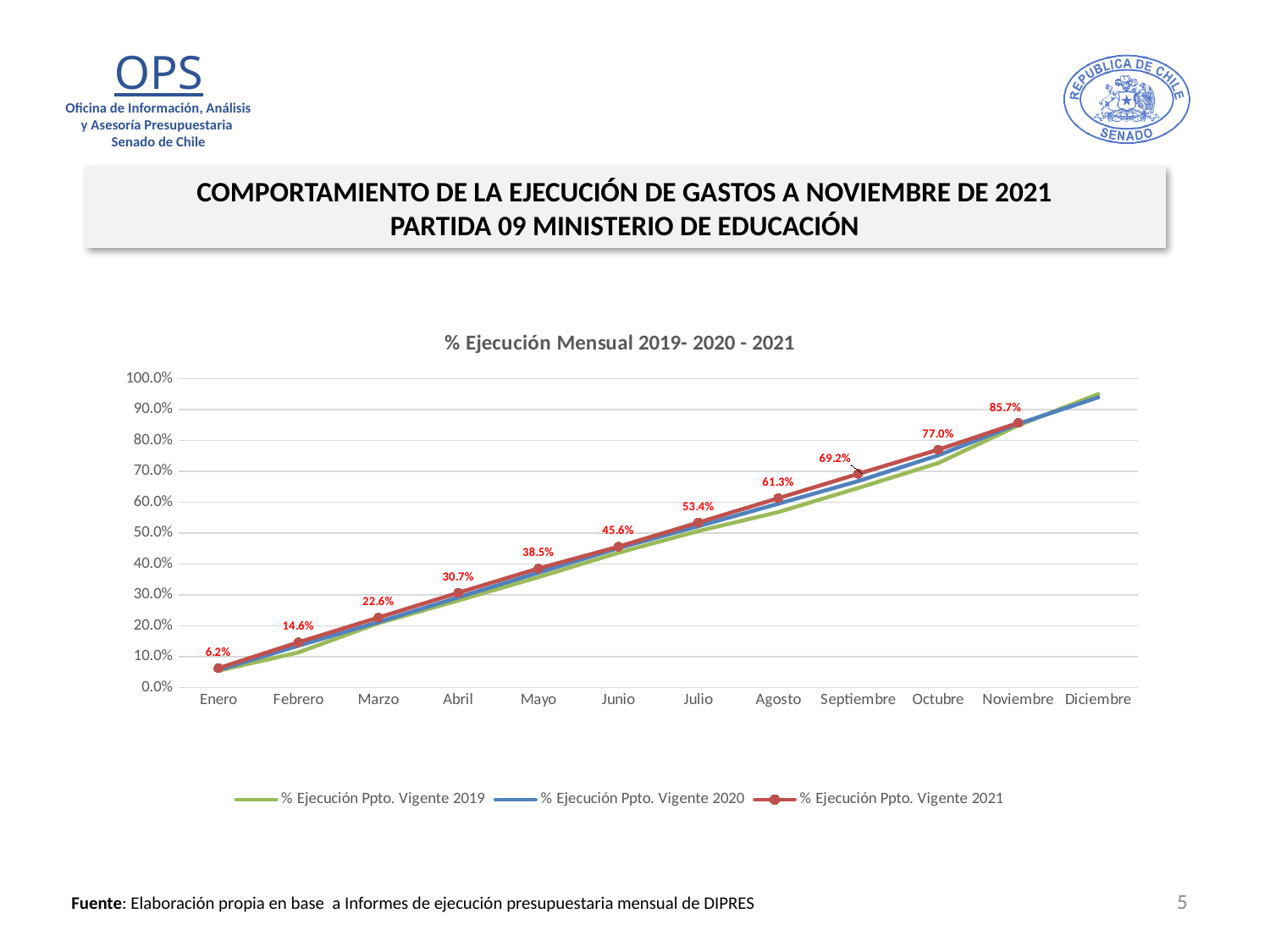
Is the value for % Ejecución Ppto. Vigente 2019 in Diciembre greater or less than 90.0%? greater Which month has the lowest labelled value for % Ejecución Ppto. Vigente 2021? Enero What is the value of % Ejecución Ppto. Vigente 2021 for Septiembre? 69.2% What is the value of % Ejecución Ppto. Vigente 2021 for Noviembre? 85.7% Which month has the highest labelled value for % Ejecución Ppto. Vigente 2021? Noviembre Do the values of % Ejecución Ppto. Vigente 2021 rise or fall from Enero to Noviembre? rise How many series does the chart legend list? 3 How many months are shown on the x axis of the chart? 12 What is the value of % Ejecución Ppto. Vigente 2021 for Enero? 6.2% What is the difference between the % Ejecución Ppto. Vigente 2021 values for Noviembre and Octubre? 8.7% What is the difference between the % Ejecución Ppto. Vigente 2021 values for Febrero and Enero? 8.4% What is the value of % Ejecución Ppto. Vigente 2021 for Junio? 45.6%